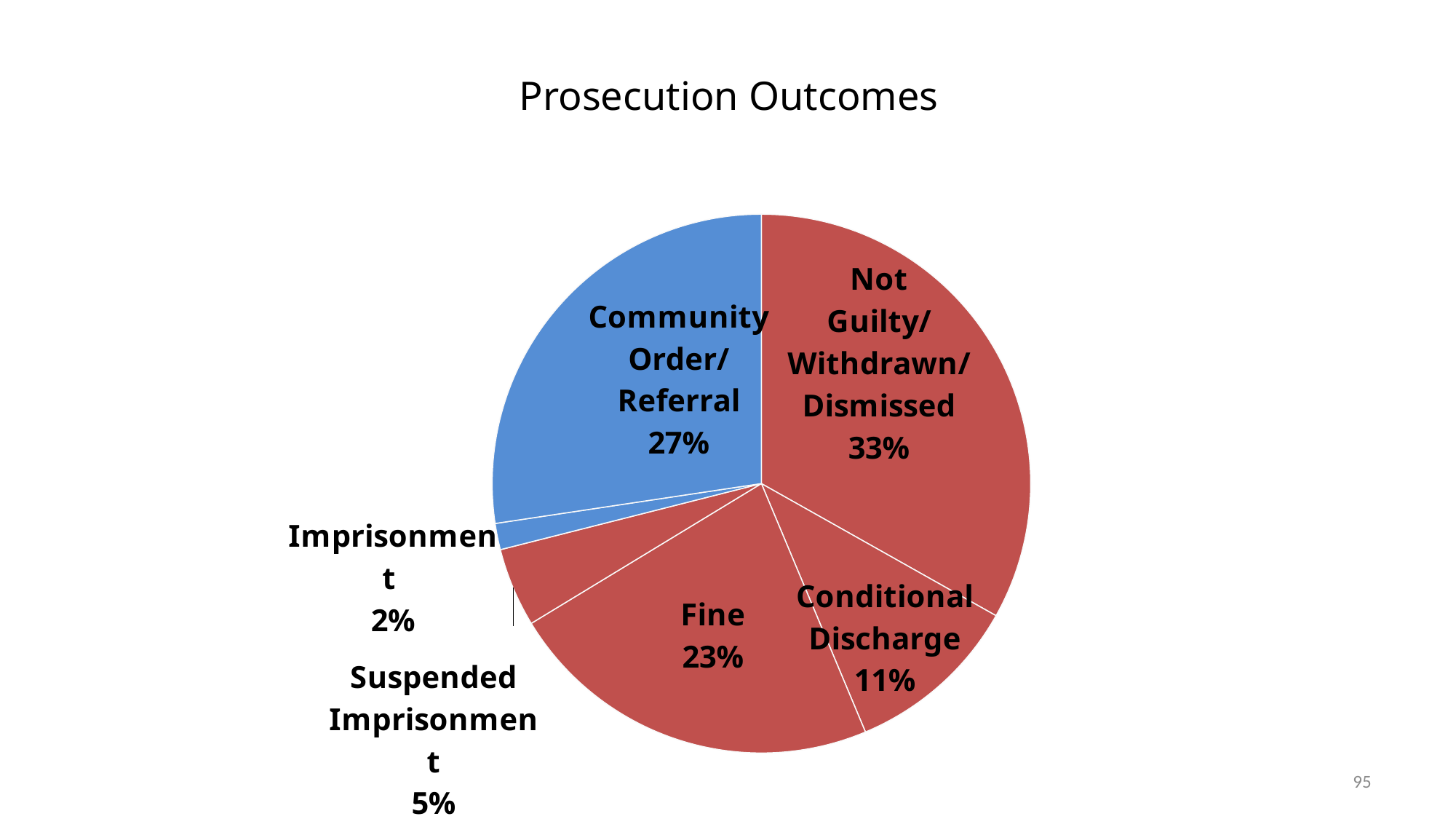
Which is larger, the share for Community Order/Referral or the share for Fine? Community Order/Referral What percentage of outcomes is Imprisonment? 2% What share of prosecution outcomes is Not Guilty/Withdrawn/Dismissed? 33% Which outcome has the largest share of the pie? Not Guilty/Withdrawn/Dismissed What percentage of outcomes is Community Order/Referral? 27% What is the title of the chart? Prosecution Outcomes Which outcome has the smallest share of the pie? Imprisonment How many slices does the pie chart have? 6 What kind of chart is shown on the slide? pie chart What percentage of outcomes is Conditional Discharge? 11% What percentage of outcomes is Fine? 23% What is the difference in percentage points between Fine and Conditional Discharge? 12